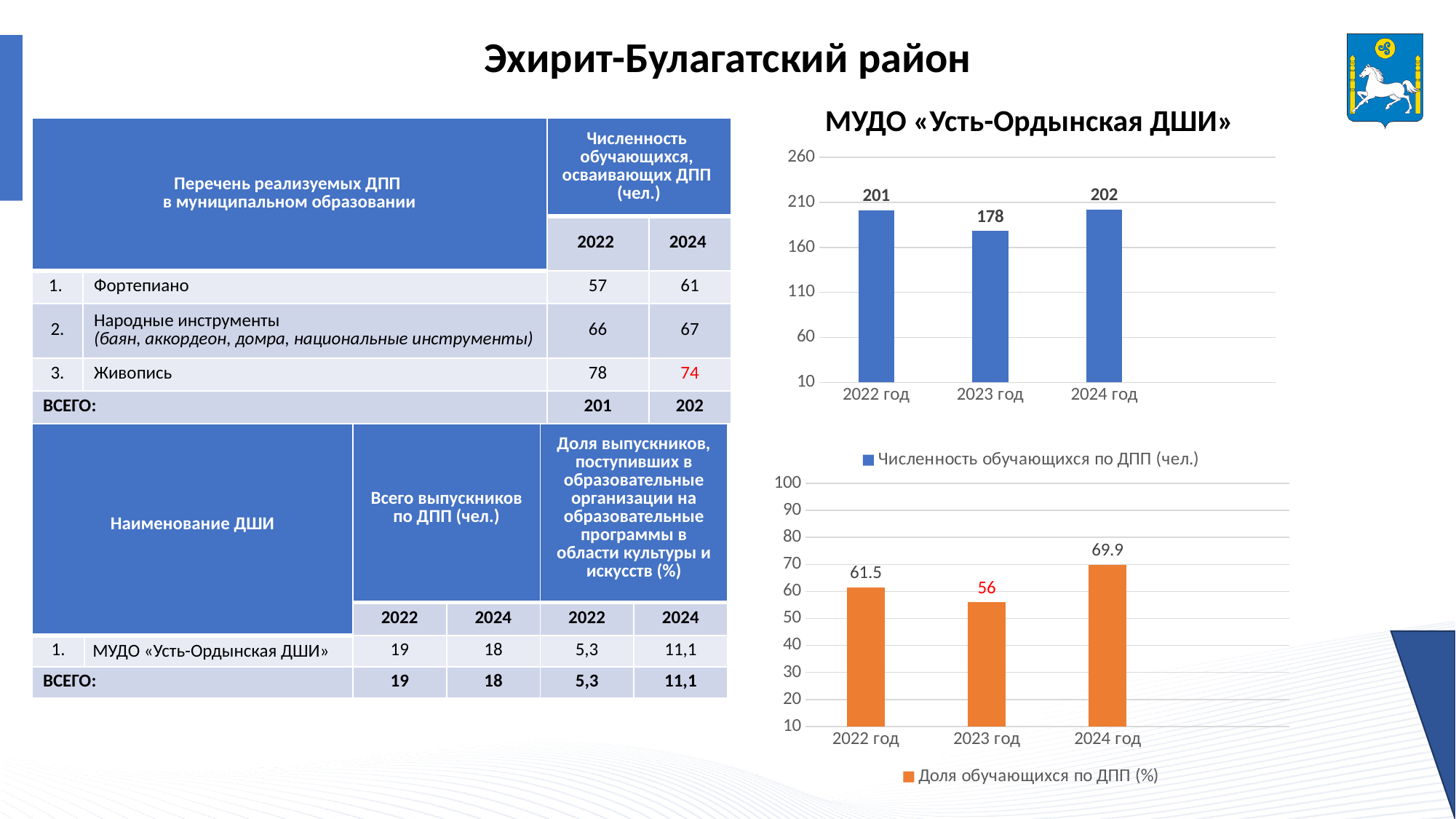
In the top chart (Численность обучающихся по ДПП), which year has the lowest value? 2023 год In the bottom chart (Доля обучающихся по ДПП), which year has the highest value? 2024 год In the top chart (Численность обучающихся по ДПП), what is the difference between the values for 2022 год and 2023 год? 23 In the top chart (Численность обучающихся по ДПП), what is the value for 2024 год? 202 What type of chart is the bottom chart (Доля обучающихся по ДПП)? bar chart In the top chart (Численность обучающихся по ДПП), what is the value for 2023 год? 178 How many bars are plotted in the top chart (Численность обучающихся по ДПП)? 3 In the bottom chart (Доля обучающихся по ДПП), what is the value for 2022 год? 61.5 In the bottom chart (Доля обучающихся по ДПП), which is larger: the value for 2022 год or 2023 год? 2022 год What is the legend entry shown below the bottom chart? Доля обучающихся по ДПП (%) In the top chart (Численность обучающихся по ДПП), is the value for 2023 год greater or less than 160? greater In the bottom chart (Доля обучающихся по ДПП), which year has the lowest value? 2023 год